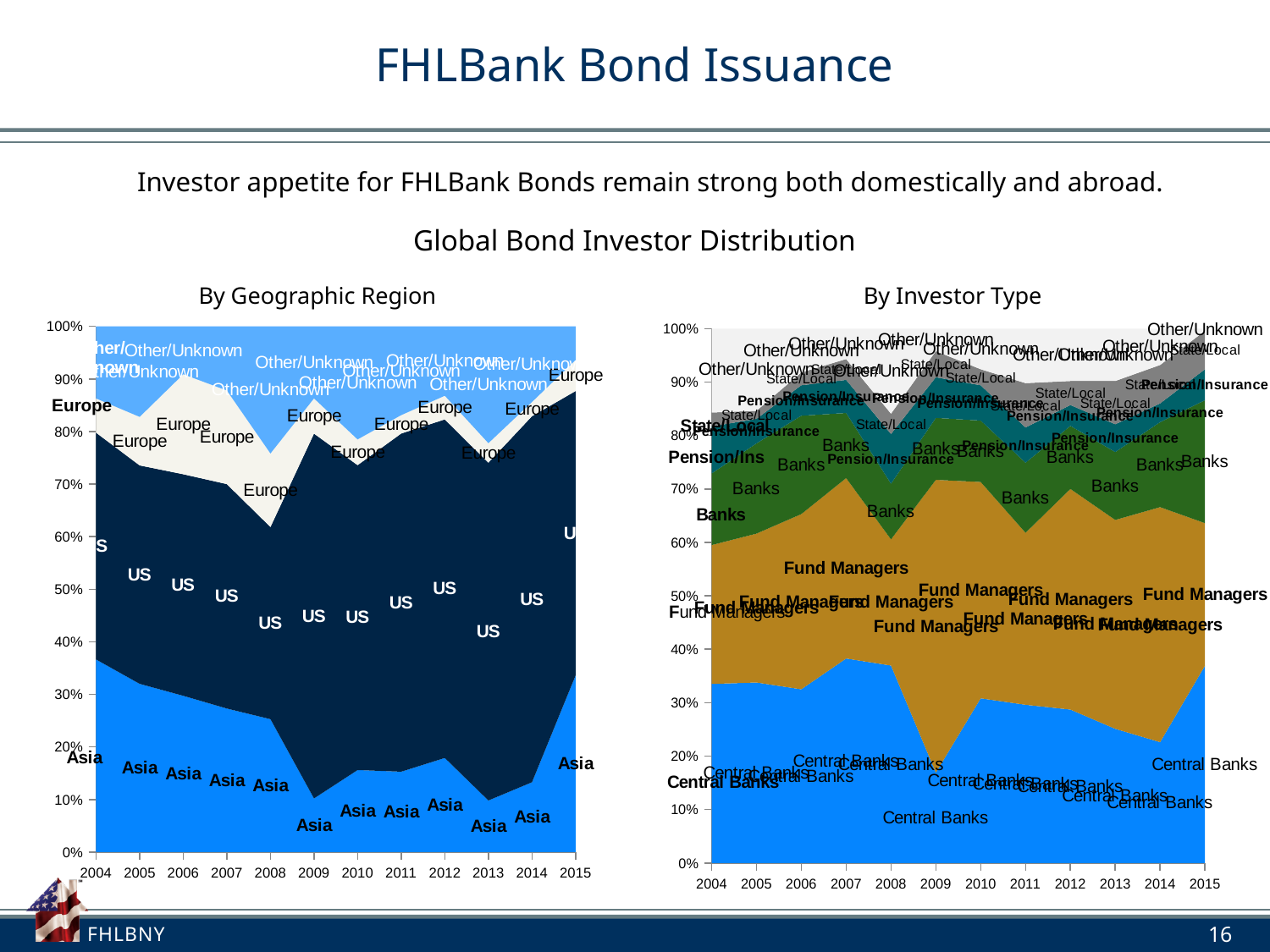
What kind of chart is the 'By Investor Type' chart? Stacked area chart What is the overall title shown above the two charts? Global Bond Investor Distribution In the 'By Investor Type' chart, is the share for Central Banks in 2004 greater or less than 30%? greater In the 'By Investor Type' chart, does the share for Central Banks rise or fall from 2004 to 2008? rise In the 'By Geographic Region' chart, is the share for Asia in 2009 greater or less than 20%? less In the 'By Geographic Region' chart, how many years are shown on the x axis? 12 In the 'By Investor Type' chart, how many years are shown on the x axis? 12 How many investor regions are labelled in the 'By Geographic Region' chart? 4 In the 'By Geographic Region' chart, does the share for Asia rise or fall from 2004 to 2009? fall How many investor types are labelled in the 'By Investor Type' chart? 6 In the 'By Geographic Region' chart, is the share for Asia in 2015 greater or less than 20%? greater What kind of chart is the 'By Geographic Region' chart? Stacked area chart